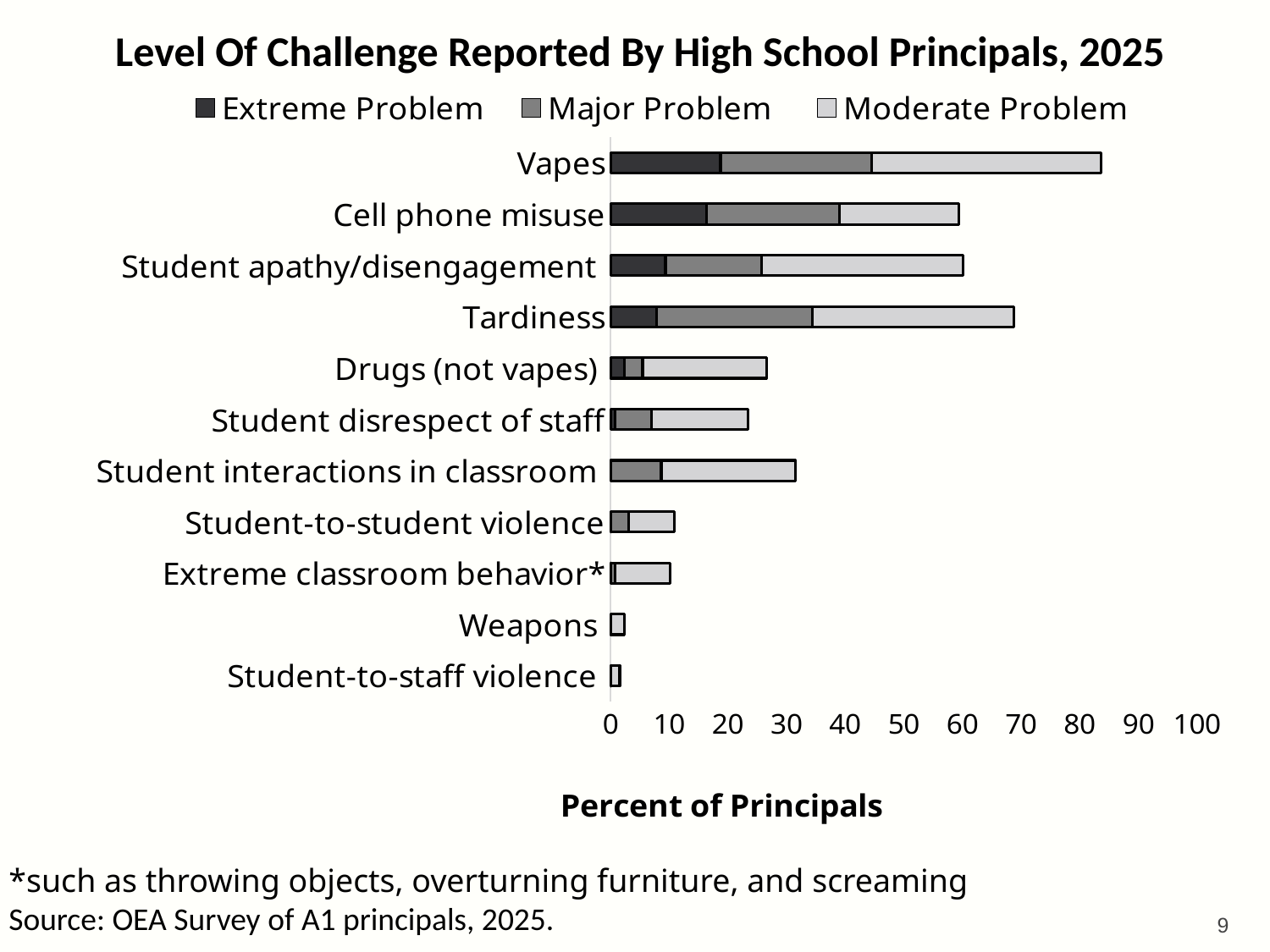
What is the title of the chart? Level Of Challenge Reported By High School Principals, 2025 Which challenge has the longest total bar? Vapes Is the total bar for Drugs (not vapes) greater or less than 30? less Which has a longer total bar, Vapes or Tardiness? Vapes What kind of chart is shown on the slide? Stacked bar chart Is the total bar for Vapes greater or less than 80? greater Which challenge has the shortest total bar? Student-to-staff violence What is the label on the horizontal axis? Percent of Principals How many series does the legend list? 3 Which has a longer total bar, Tardiness or Cell phone misuse? Tardiness How many categories (challenges) are listed on the chart? 11 Is the total bar for Weapons greater or less than 10? less